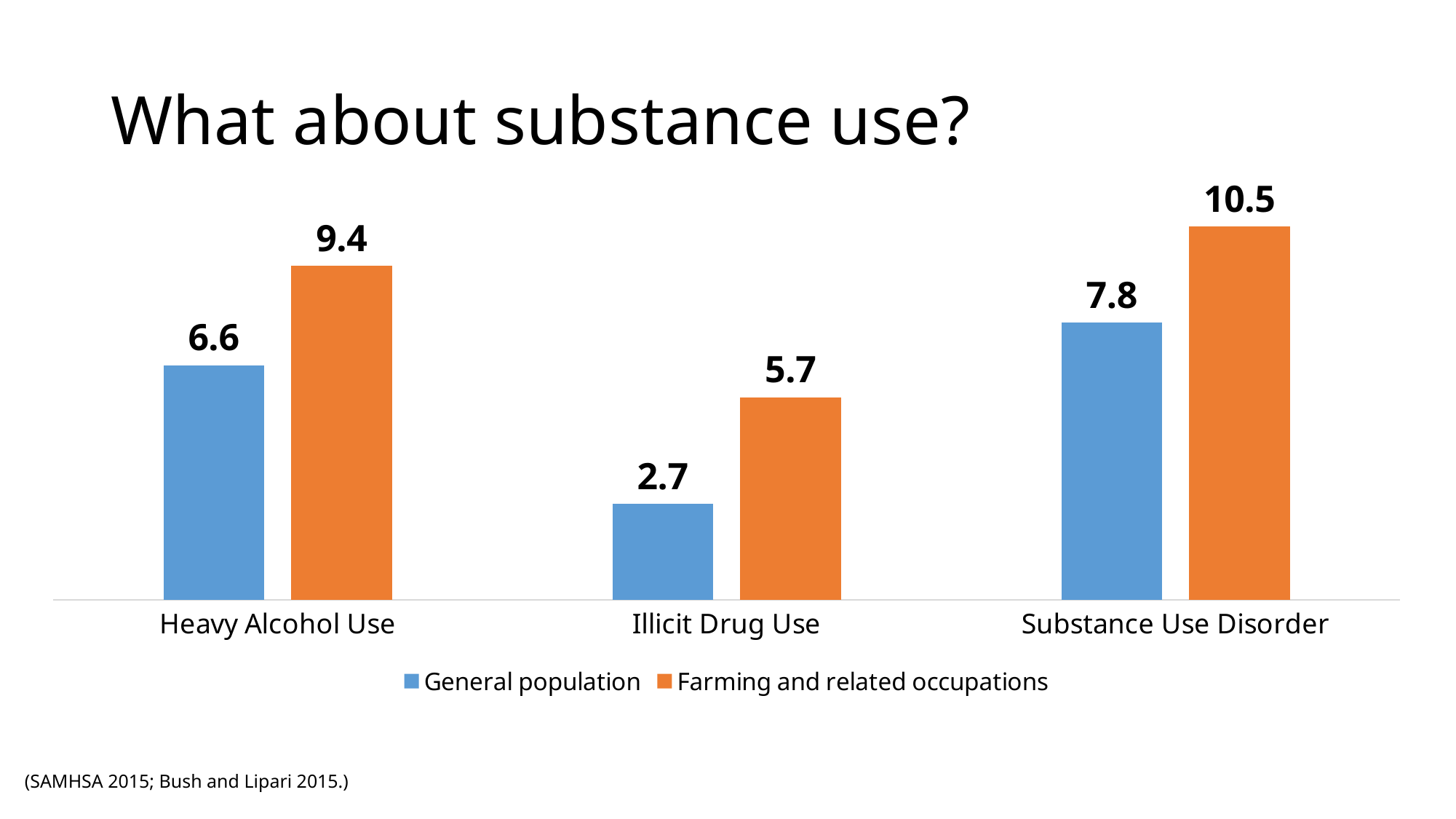
Which category has the lowest value for General population? Illicit Drug Use Which is larger for Illicit Drug Use: General population or Farming and related occupations? Farming and related occupations How many series does the legend list? 2 What is the value for Farming and related occupations for Substance Use Disorder? 10.5 Which category has the highest value for Farming and related occupations? Substance Use Disorder What is the value for General population for Heavy Alcohol Use? 6.6 How many categories are shown on the x axis? 3 What is the value for Farming and related occupations for Illicit Drug Use? 5.7 What is the difference between Farming and related occupations and General population for Substance Use Disorder? 2.7 What kind of chart is shown on the slide? Bar chart What is the value for General population for Illicit Drug Use? 2.7 What is the difference between Farming and related occupations and General population for Heavy Alcohol Use? 2.8